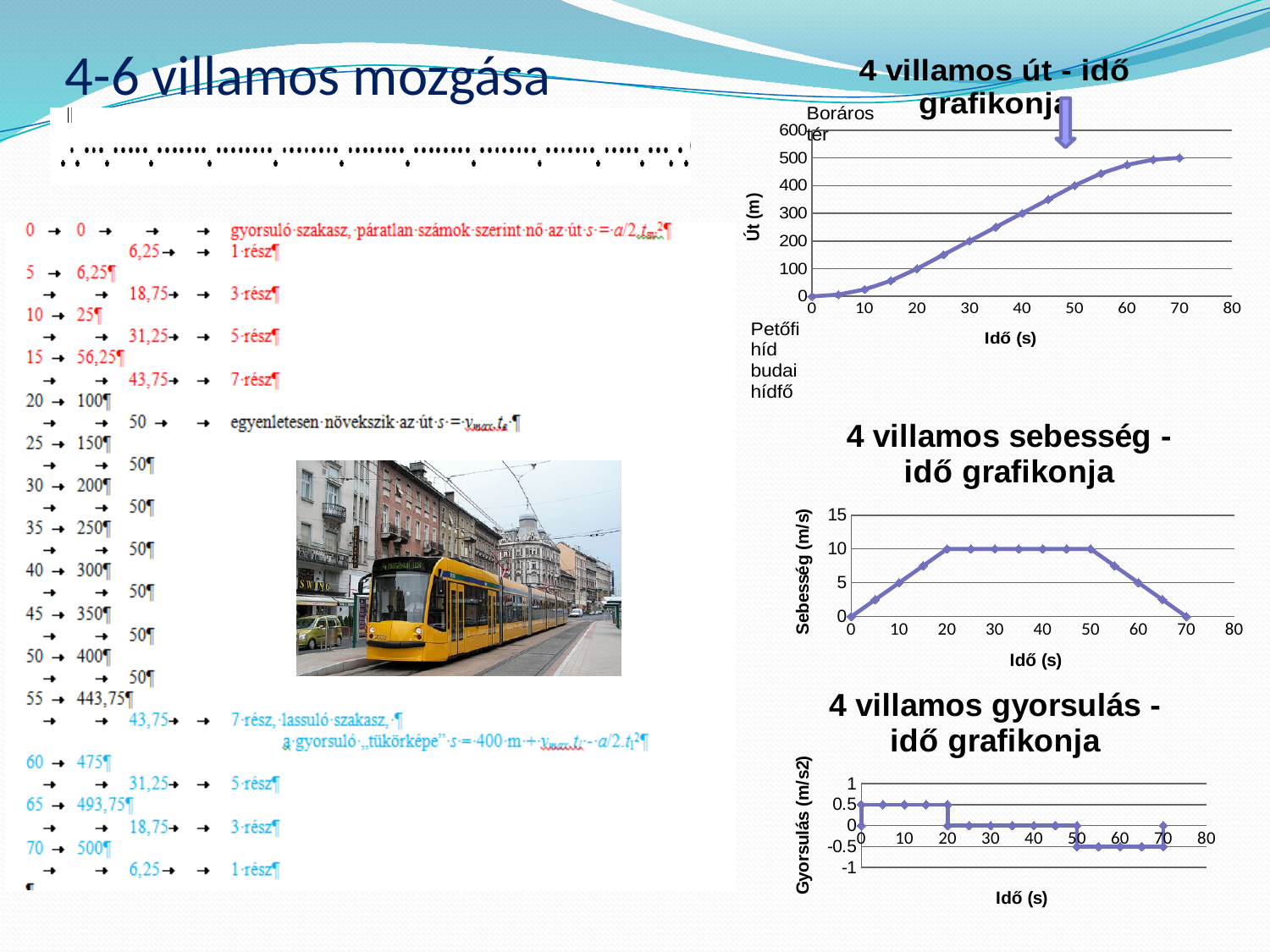
What is the y-axis label of the '4 villamos gyorsulás - idő grafikonja' chart? Gyorsulás (m/s2) In the '4 villamos sebesség - idő grafikonja' chart, what is the velocity at 30 s? 10 In the '4 villamos sebesség - idő grafikonja' chart, what is the maximum velocity reached? 10 What is the x-axis label of the '4 villamos sebesség - idő grafikonja' chart? Idő (s) What kind of chart is the '4 villamos út - idő grafikonja' chart? line chart In the '4 villamos sebesség - idő grafikonja' chart, what is the velocity at 10 s? 5 In the '4 villamos gyorsulás - idő grafikonja' chart, what is the acceleration between 0 and 20 s? 0.5 In the '4 villamos gyorsulás - idő grafikonja' chart, what is the acceleration between 50 and 70 s? -0.5 In the '4 villamos út - idő grafikonja' chart, does the distance rise or fall as time increases? rise In the '4 villamos út - idő grafikonja' chart, is the distance at 60 s greater or less than 400? greater In the '4 villamos sebesség - idő grafikonja' chart, does the velocity rise or fall between 50 s and 70 s? fall In the '4 villamos út - idő grafikonja' chart, what is the distance at 70 s? 500